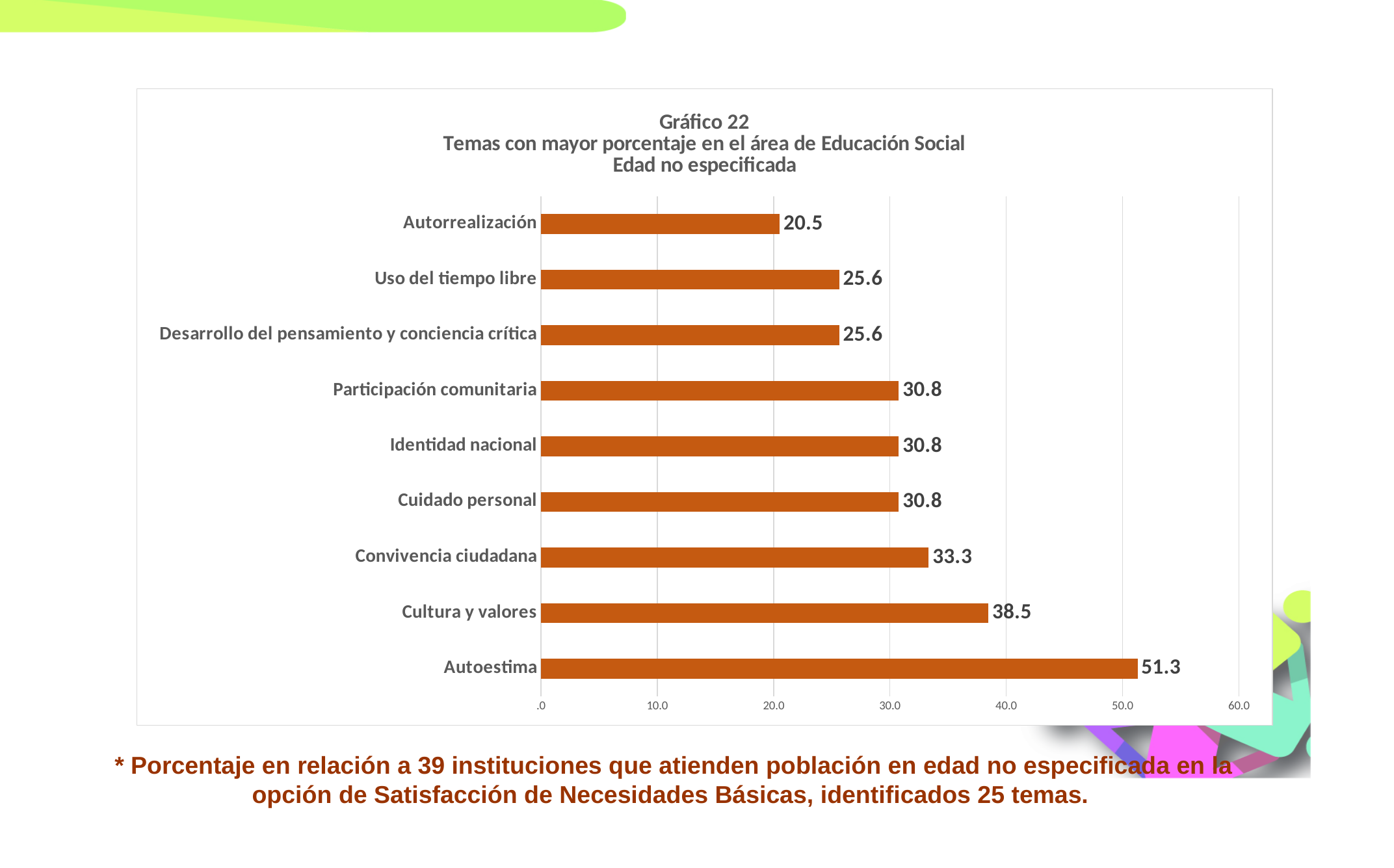
What is the value for Convivencia ciudadana? 33.3 Which category has the highest value? Autoestima How many categories are shown in the chart? 9 What is the value for Autorrealización? 20.5 What is the value for Uso del tiempo libre? 25.6 What kind of chart is shown on the slide? Bar chart What is the difference between the values for Autoestima and Cultura y valores? 12.8 What is the value for Cultura y valores? 38.5 Which category has the lowest value? Autorrealización What is the title of the chart? Gráfico 22 Temas con mayor porcentaje en el área de Educación Social Edad no especificada Which is larger, the value for Convivencia ciudadana or the value for Identidad nacional? Convivencia ciudadana What is the value for Autoestima? 51.3